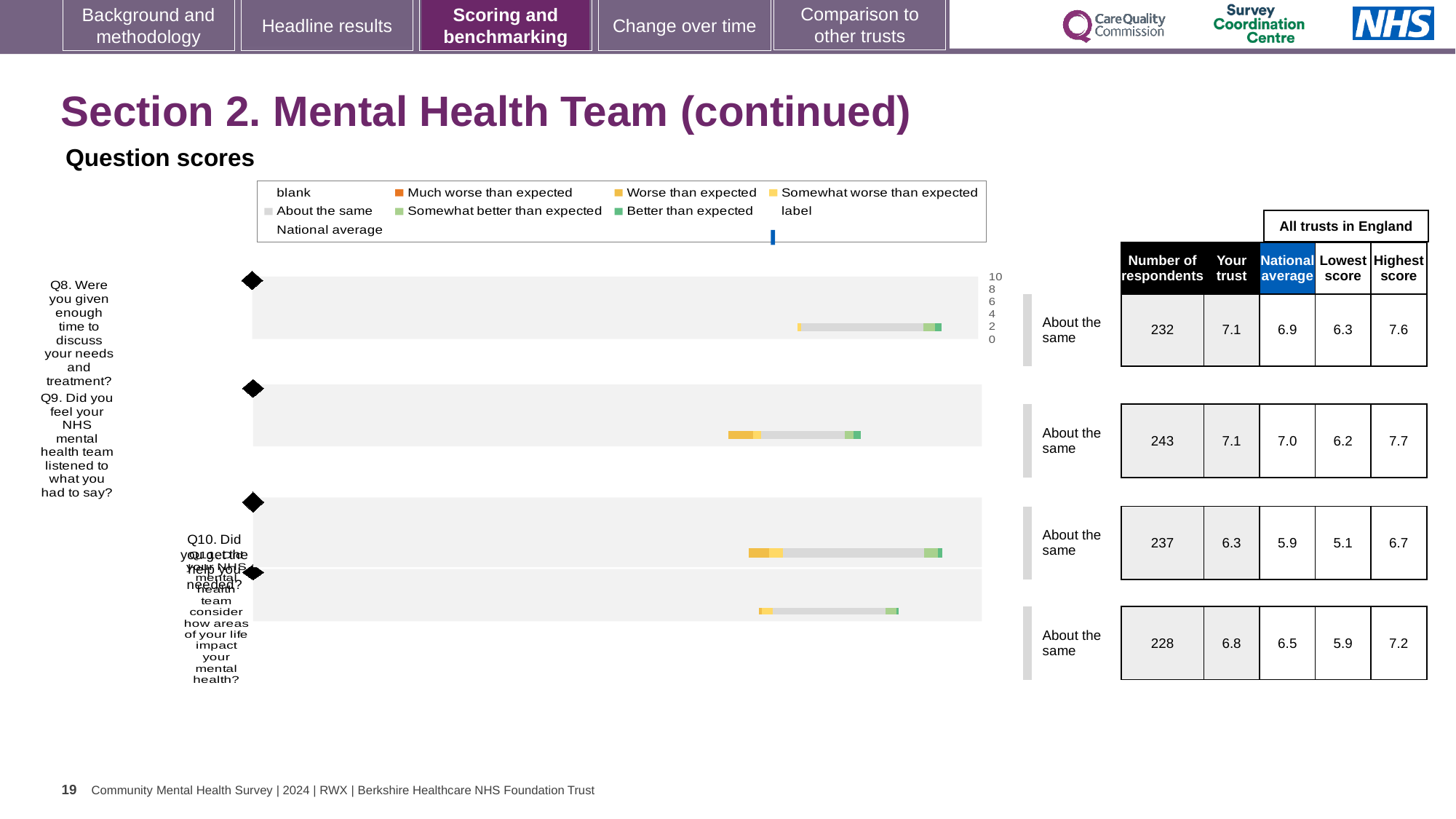
How many respondents are shown for Q11 (Did your NHS mental health team consider how areas of your life impact your mental health?)? 228 How many questions (categories) are plotted in the question scores chart? 4 How many entries does the legend of the question scores chart list? 9 What is the national average shown for Q9 (Did you feel your NHS mental health team listened to what you had to say?)? 7.0 What is the difference between the 'Your trust' score and the national average for Q10? 0.4 Which question has the lowest 'Your trust' score on this slide? Q10. Did you get the help you needed? What benchmark category is shown for Q8 on this slide? About the same What is the 'Your trust' score shown for Q8 (Were you given enough time to discuss your needs and treatment?)? 7.1 In the legend of the question scores chart, which colour represents 'About the same'? grey What is the 'Your trust' score shown for Q10 (Did you get the help you needed?)? 6.3 In the legend of the question scores chart, which colour represents 'Much worse than expected'? orange What kind of chart is used to show the question scores on this slide? bar chart